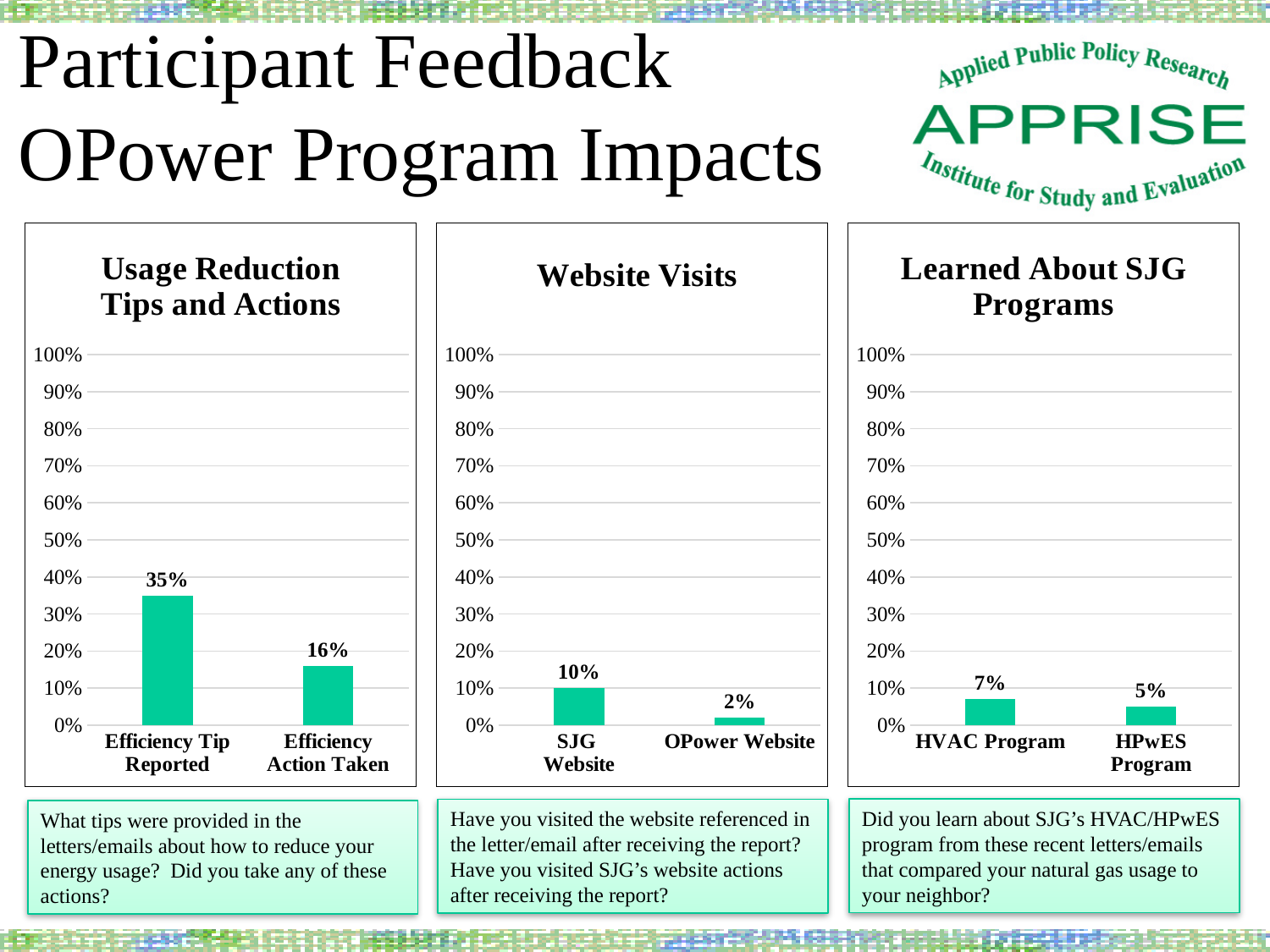
In the 'Usage Reduction Tips and Actions' chart, what is the difference between Efficiency Tip Reported and Efficiency Action Taken? 19% In the 'Learned About SJG Programs' chart, what is the value for HPwES Program? 5% How many categories are shown in the 'Website Visits' chart? 2 In the 'Usage Reduction Tips and Actions' chart, what is the value for Efficiency Tip Reported? 35% In the 'Website Visits' chart, which category has the highest value? SJG Website In the 'Usage Reduction Tips and Actions' chart, what is the value for Efficiency Action Taken? 16% What kind of chart is the 'Learned About SJG Programs' chart? bar chart In the 'Learned About SJG Programs' chart, what is the value for HVAC Program? 7% In the 'Website Visits' chart, what is the value for SJG Website? 10% In the 'Website Visits' chart, what is the value for OPower Website? 2% In the 'Learned About SJG Programs' chart, which category has the lowest value? HPwES Program In the 'Usage Reduction Tips and Actions' chart, is the value for Efficiency Tip Reported greater or less than 30%? greater